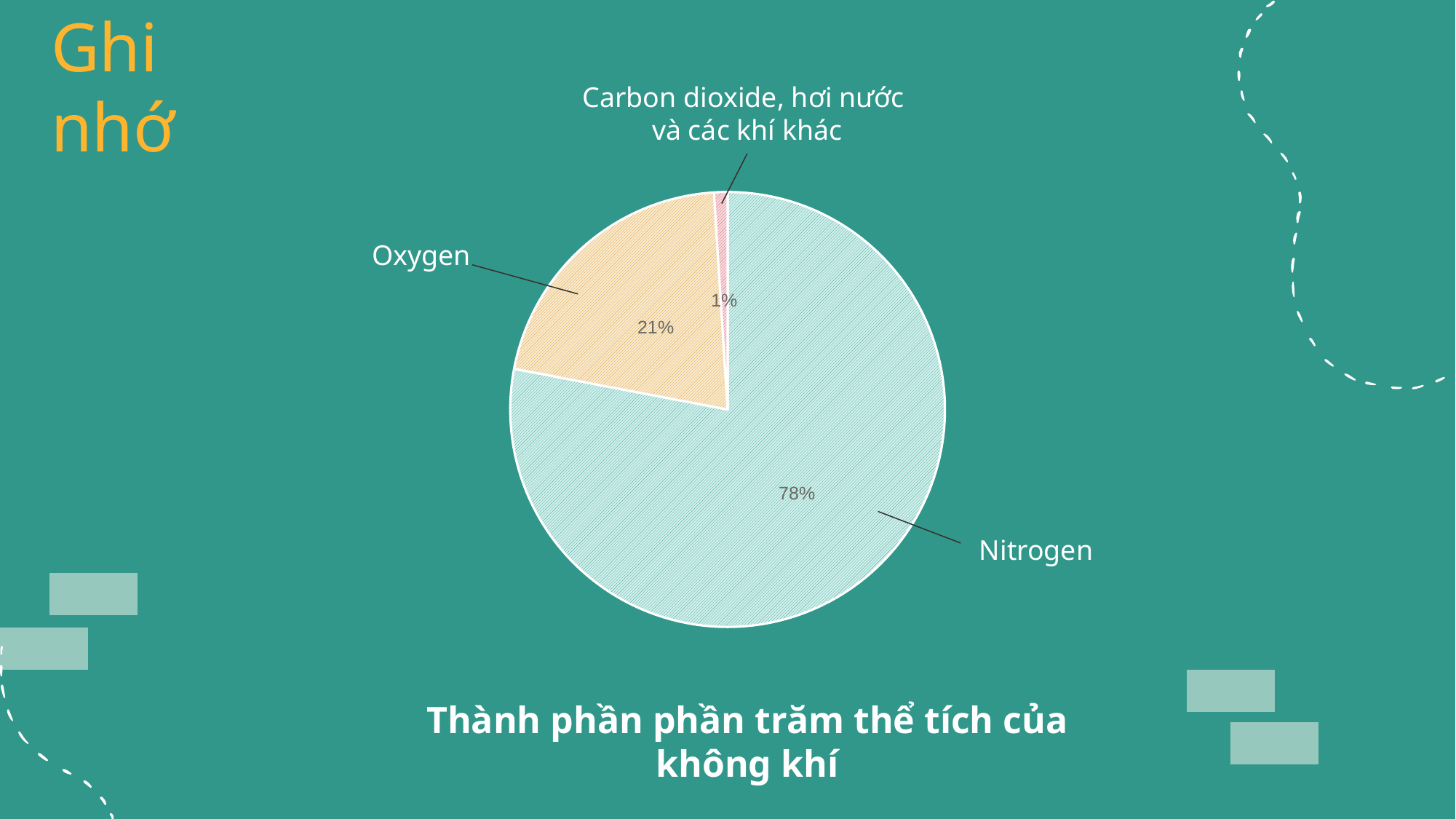
What percentage of the pie does Nitrogen account for? 78% What percentage of the pie does Oxygen account for? 21% What is the combined share of Oxygen and the 'Carbon dioxide, hơi nước và các khí khác' slice? 22% What colour is the Oxygen slice? orange Which slice of the pie is the smallest? Carbon dioxide, hơi nước và các khí khác Which slice of the pie is the largest? Nitrogen Which is larger, the Oxygen slice or the Nitrogen slice? Nitrogen What is the title of the chart? Thành phần phần trăm thể tích của không khí How many slices does the pie chart have? 3 What percentage is shown for the slice labelled 'Carbon dioxide, hơi nước và các khí khác'? 1% What is the difference in percentage points between the Nitrogen slice and the Oxygen slice? 57 What kind of chart is shown on the slide? pie chart